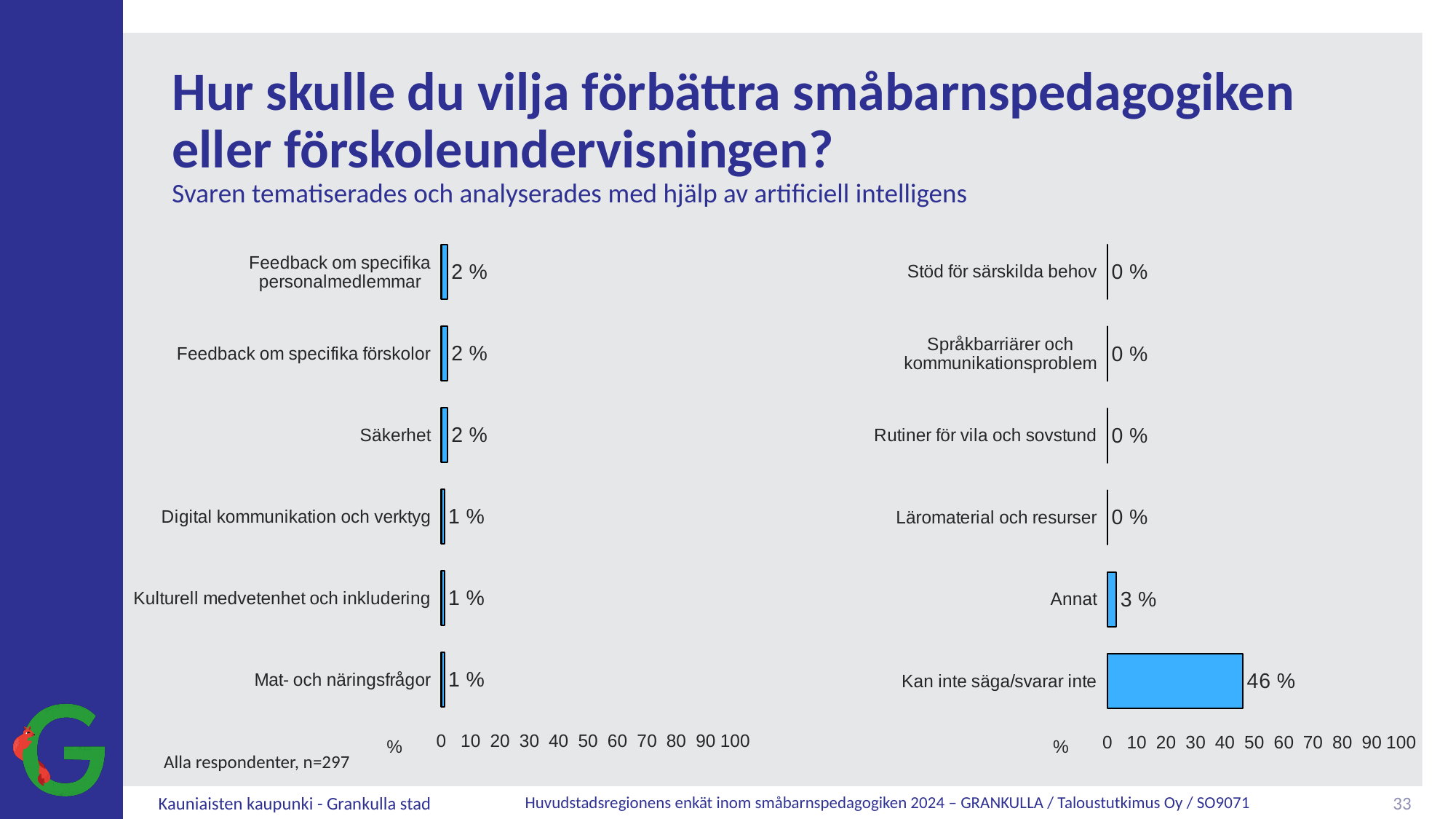
In the left chart, what is the value for Säkerhet? 2 % In the left chart, what is the difference between Feedback om specifika förskolor and Digital kommunikation och verktyg? 1 % In the right chart, what is the value for Kan inte säga/svarar inte? 46 % In the right chart, what is the value for Stöd för särskilda behov? 0 % In the right chart, which category has the highest value? Kan inte säga/svarar inte In the right chart, what is the value for Annat? 3 % In the left chart, which is larger: Säkerhet or Kulturell medvetenhet och inkludering? Säkerhet In the right chart, what is the difference between Kan inte säga/svarar inte and Annat? 43 % In the left chart, what is the value for Mat- och näringsfrågor? 1 % What kind of chart is the right chart? bar chart How many categories does the left chart show? 6 In the right chart, is the value for Kan inte säga/svarar inte greater or less than 40? greater